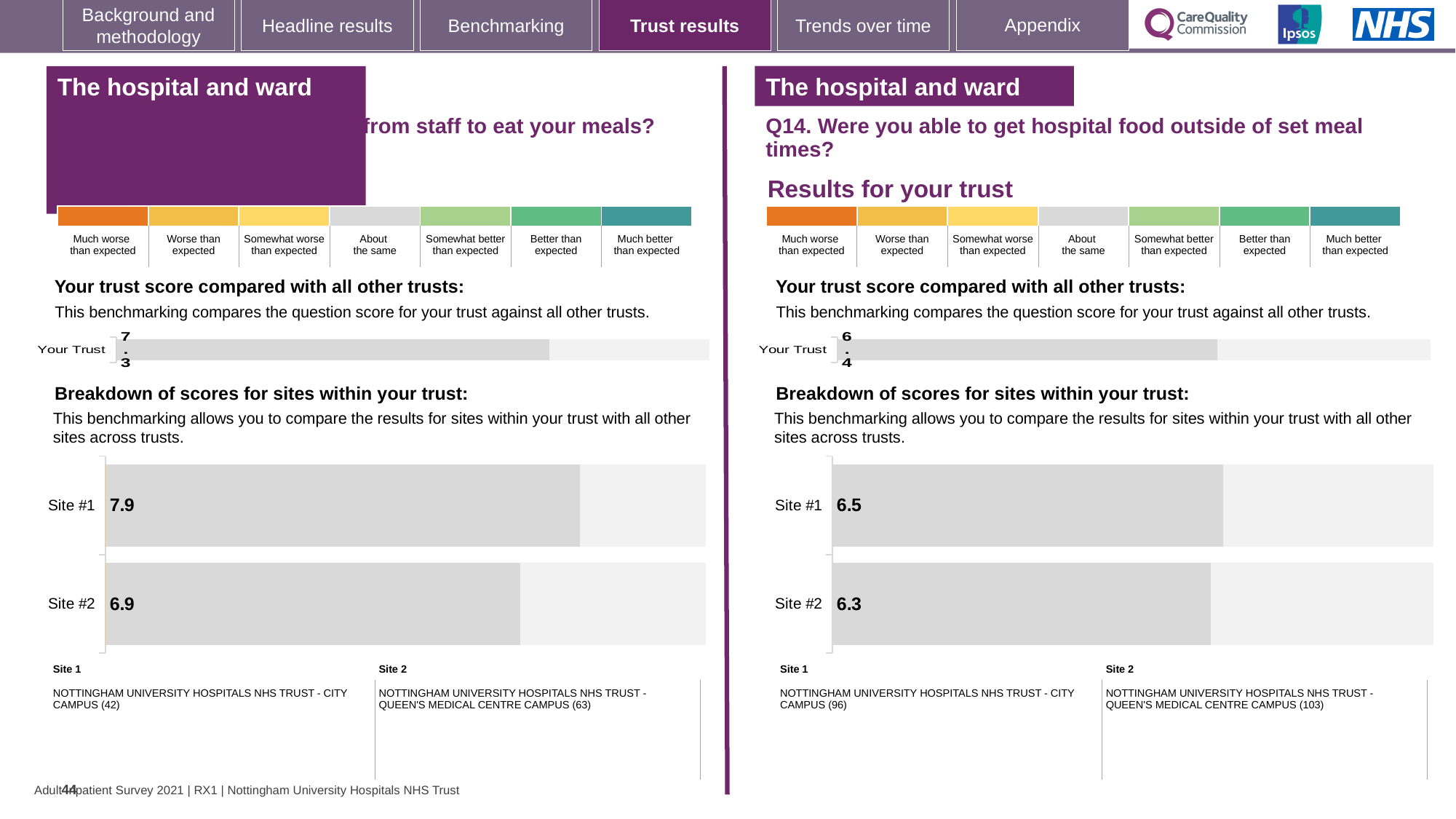
In the Q14 site breakdown chart, what is the difference between the Site #1 and Site #2 scores? 0.2 On the left-hand side of the slide, what is the 'Your Trust' score in the trust score comparison chart? 7.3 In the Q14 (hospital food outside of set meal times) site breakdown chart, what is the score for Site #1? 6.5 In the Q14 site breakdown chart, how many sites are shown? 2 In the Q14 (hospital food outside of set meal times) site breakdown chart, what is the score for Site #2? 6.3 Is the Site #1 score on the left-hand site breakdown chart larger or smaller than the Site #1 score on the Q14 site breakdown chart? Larger On the left-hand side of the slide, what is the difference between the Site #1 and Site #2 scores in the site breakdown chart? 1.0 On the left-hand side of the slide, what is the score shown for Site #1 in the breakdown of scores for sites within your trust? 7.9 On the left-hand side of the slide, what is the score shown for Site #2 in the breakdown of scores for sites within your trust? 6.9 What type of chart is used for the breakdown of scores for sites within your trust on the right-hand side of the slide? Bar chart On the left-hand side of the slide, which site has the higher score in the breakdown of scores for sites within your trust? Site #1 In the Q14 (hospital food outside of set meal times) trust score comparison chart, what is the 'Your Trust' score? 6.4